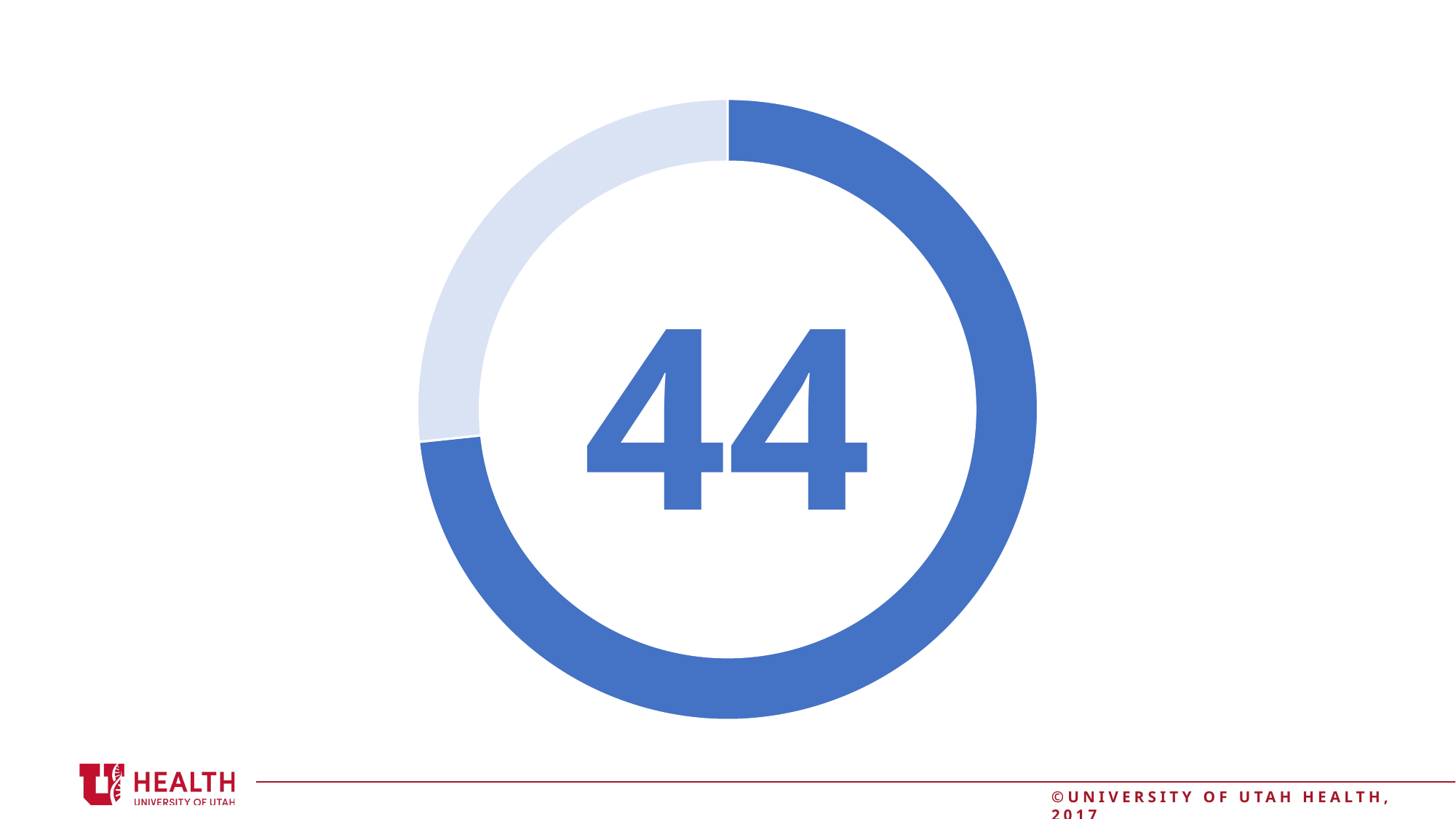
Which segment of the doughnut chart is the smallest? The light blue segment What kind of chart is shown on the slide? Doughnut chart Does the doughnut chart have a legend? No What number is displayed in the centre of the doughnut chart? 44 Which segment of the doughnut chart is larger, the dark blue one or the light blue one? Dark blue How many segments does the doughnut chart have? 2